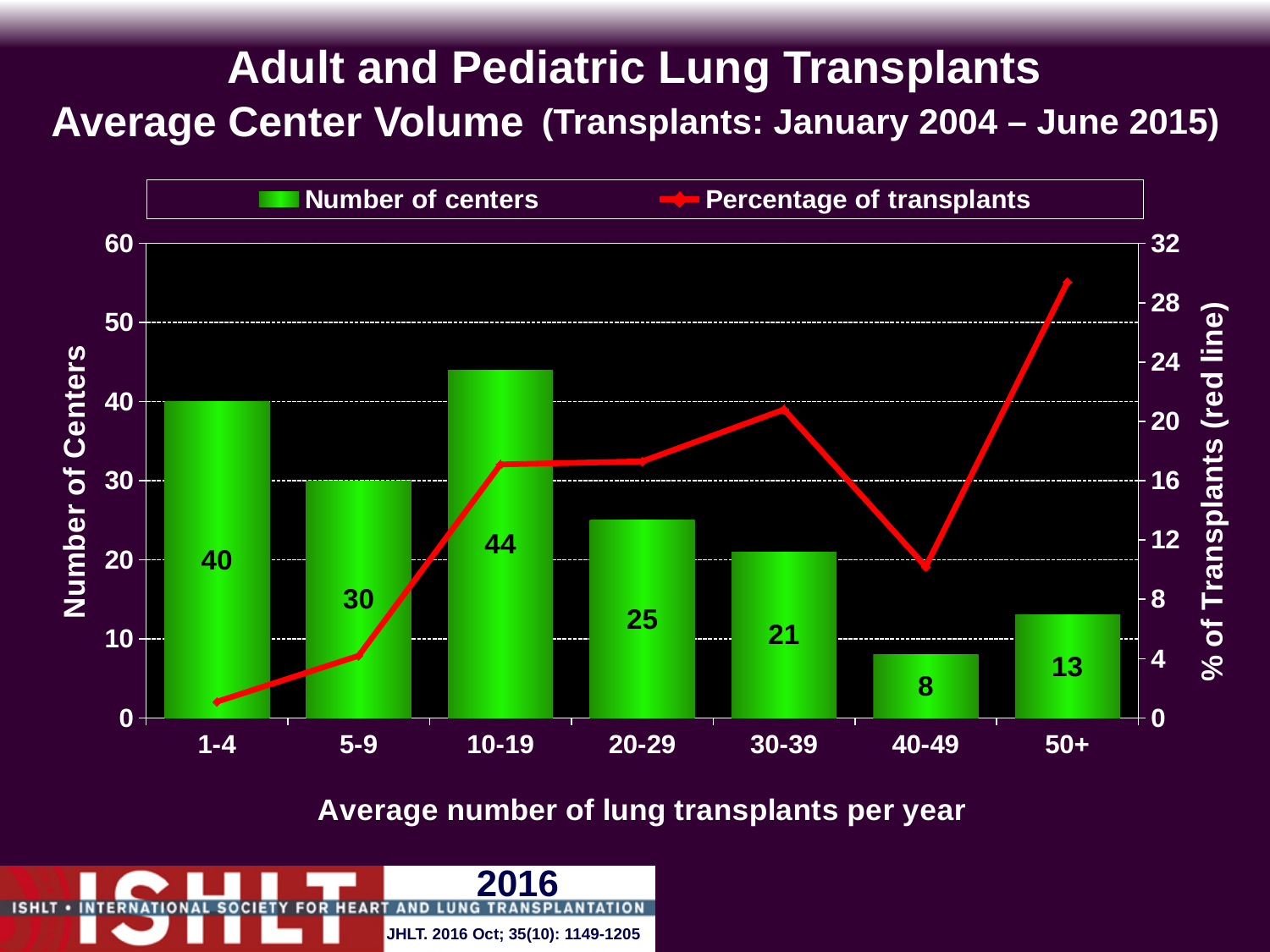
Which has more centers, the 20-29 category or the 50+ category? 20-29 What is the label of the right-hand y axis? % of Transplants (red line) Is the percentage of transplants for the 50+ category greater or less than 24? greater What is the difference in number of centers between the 1-4 and 5-9 categories? 10 How many categories are shown on the x axis? 7 Which category has the lowest number of centers? 40-49 How many series does the legend list? 2 Is the percentage of transplants for the 1-4 category greater or less than 4? less How many centers are in the 10-19 category? 44 What is the number of centers for the 40-49 category? 8 Which category has the highest number of centers? 10-19 Is the percentage of transplants for the 40-49 category greater or less than 12? less